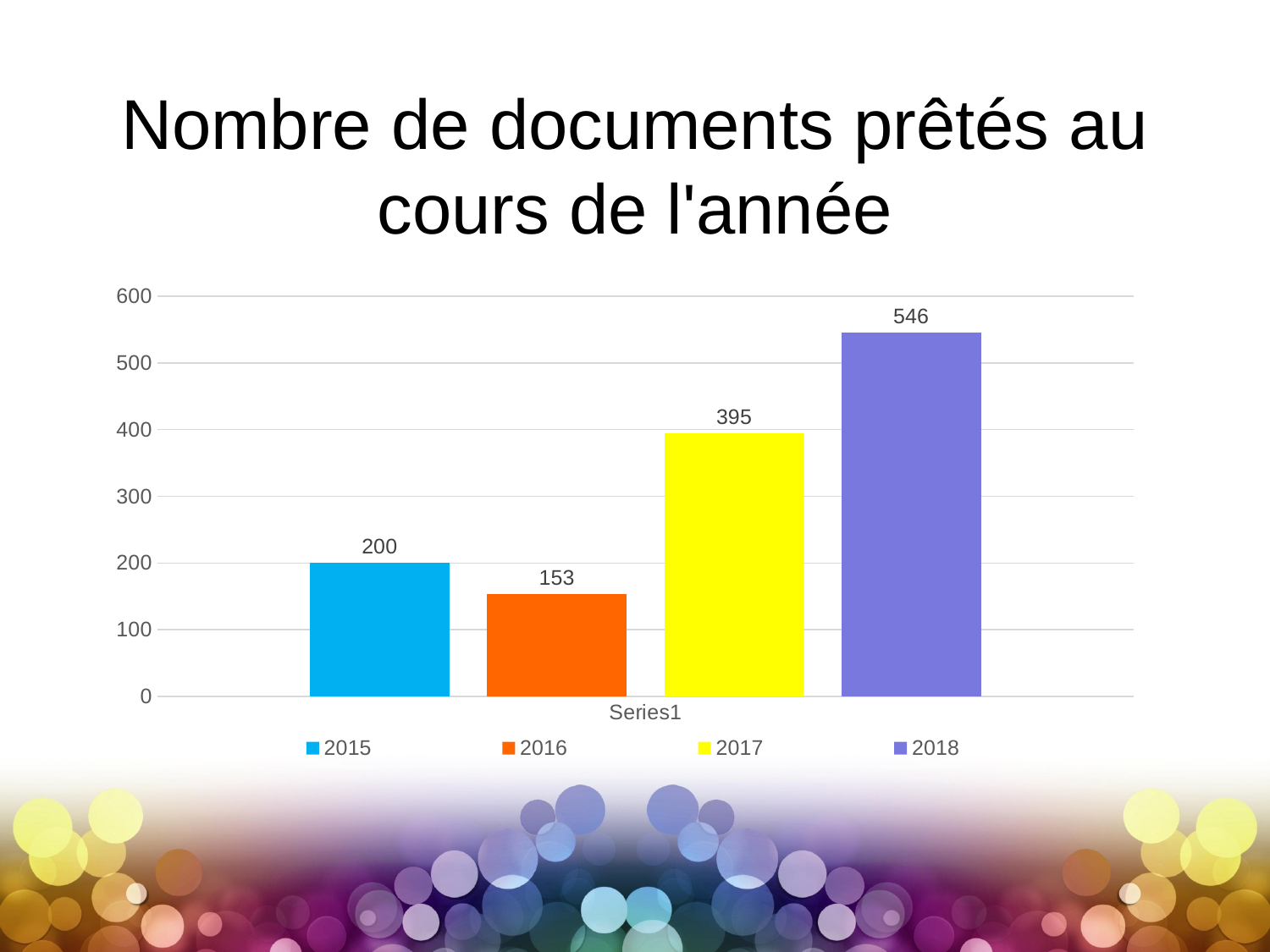
What is the value for 2018? 546 What is the value for 2017? 395 Which year has the highest value? 2018 What is the title of the slide's chart? Nombre de documents prêtés au cours de l'année What is the value for 2016? 153 Which is larger, the value for 2017 or the value for 2015? 2017 What kind of chart is shown on the slide? Bar chart What is the difference between the values for 2018 and 2017? 151 How many series does the legend list? 4 Which year has the lowest value? 2016 What is the difference between the values for 2015 and 2016? 47 What is the value for 2015? 200